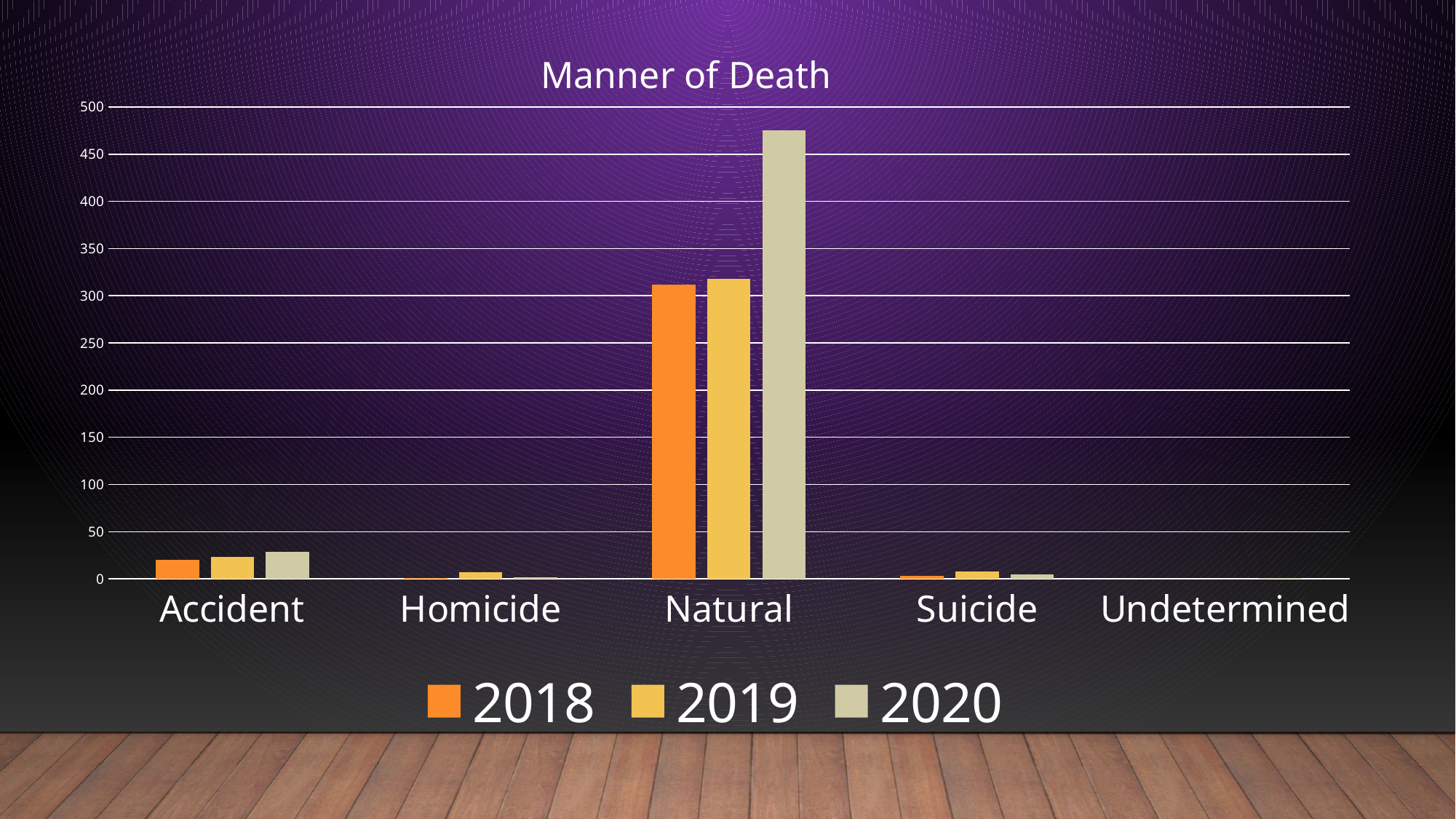
Is the value for Natural in 2018 greater or less than 350? less What is the title of the chart? Manner of Death Which category has the lowest value for 2020? Undetermined Which category has the highest value for 2020? Natural Which category has the larger 2020 value: Accident or Homicide? Accident Is the value for Natural in 2019 greater or less than 300? greater How many series does the legend list? 3 Is the value for Natural in 2020 greater or less than 450? greater What kind of chart is shown on the slide? bar chart How many categories are shown on the x axis? 5 Which is larger for Natural: the 2018 value or the 2020 value? 2020